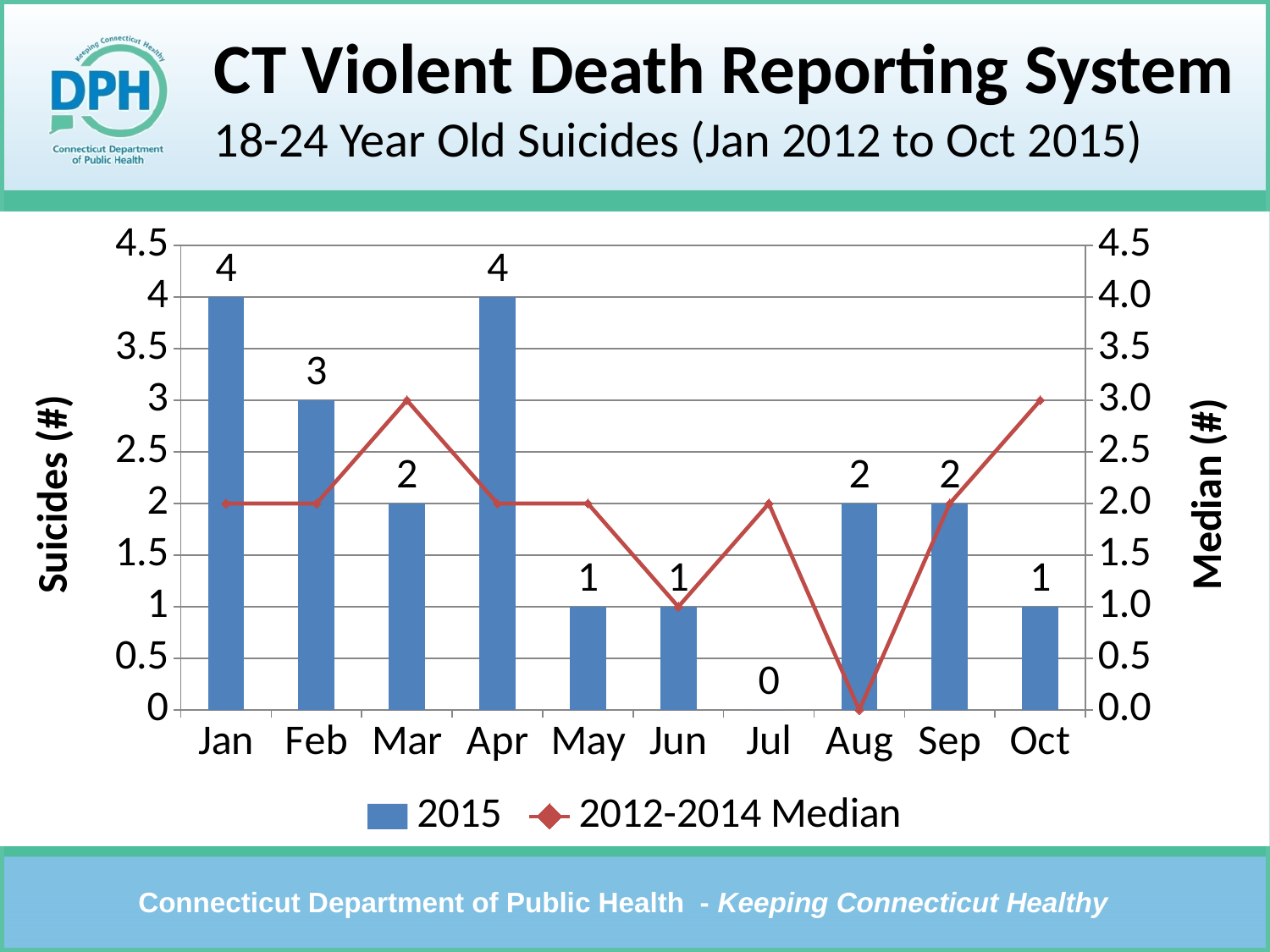
What is the number of 2015 suicides shown for January? 4 How many series does the legend list? 2 What kind of chart is used to show the 2015 values? bar chart Is the 2012-2014 Median value for March greater or less than 2.5? greater How many months are shown on the x axis? 10 What is the number of 2015 suicides shown for July? 0 What is the title of the right-hand vertical axis? Median (#) Which month has the larger 2015 suicide count, February or August? Feb What is the number of 2015 suicides shown for February? 3 Which month has the lowest 2015 suicide count? Jul What is the difference between the 2015 suicide counts for April and May? 3 Do the 2015 suicide counts rise or fall from April to July? fall